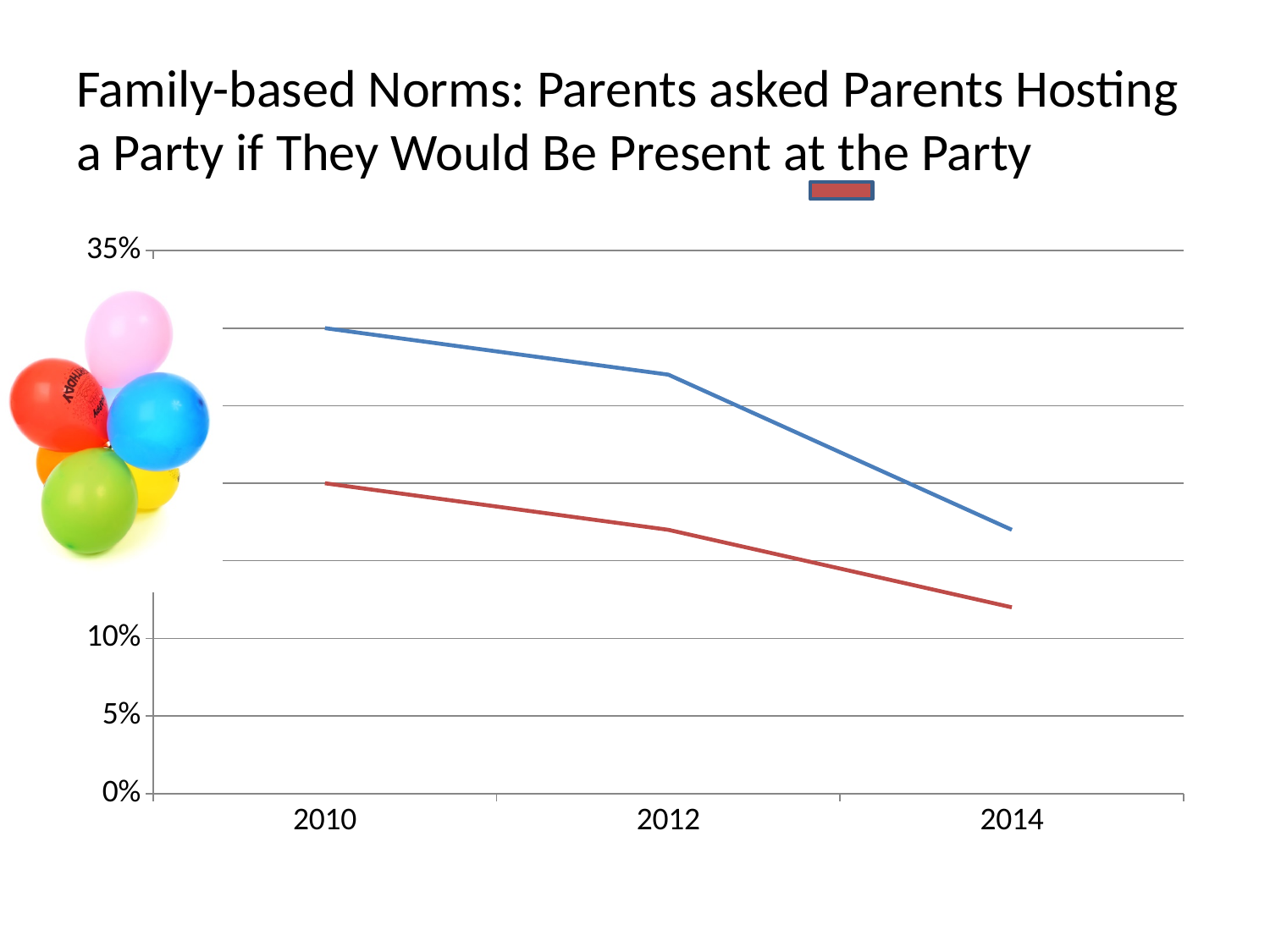
In which year does the blue line reach its highest value? 2010 Does the red line rise or fall from 2010 to 2014? fall How many lines are plotted on the chart? 2 Which years are labelled on the x axis of the chart? 2010, 2012, 2014 In which year does the red line reach its lowest value? 2014 How many years are plotted along the x axis? 3 Is the value of the blue line in 2014 greater or less than 10%? greater Does the blue line rise or fall from 2010 to 2014? fall Is the value of the blue line in 2010 greater or less than 10%? greater Is the value of the red line in 2014 greater or less than 35%? less In 2014, which line has the higher value, the blue line or the red line? blue line What kind of chart is shown on the slide? line chart